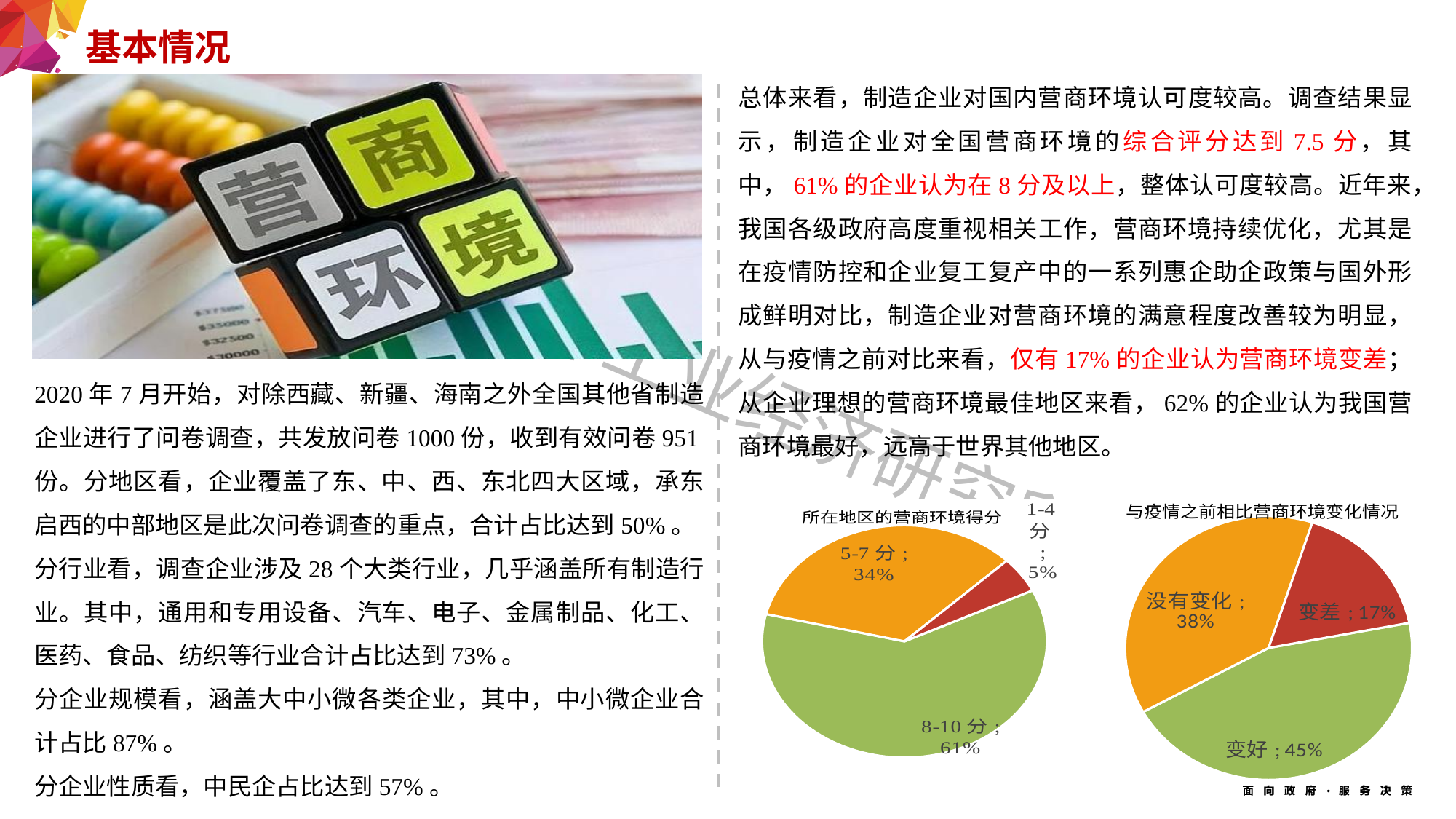
In the chart titled 与疫情之前相比营商环境变化情况, what share of enterprises answered 变差? 17% In the chart titled 所在地区的营商环境得分, what share of enterprises gave a score of 5-7 分? 34% In the chart titled 所在地区的营商环境得分, which score range has the smallest share? 1-4 分 In the chart titled 与疫情之前相比营商环境变化情况, what share of enterprises answered 变好? 45% What type of chart is the one titled 所在地区的营商环境得分? Pie chart In the chart titled 与疫情之前相比营商环境变化情况, which response has the largest share? 变好 In the chart titled 所在地区的营商环境得分, which score range has the largest share? 8-10 分 In the chart titled 与疫情之前相比营商环境变化情况, what share of enterprises answered 没有变化? 38% In the chart titled 与疫情之前相比营商环境变化情况, how many slices does the pie have? 3 In the chart titled 所在地区的营商环境得分, what is the difference in percentage points between the 8-10 分 slice and the 5-7 分 slice? 27 In the chart titled 所在地区的营商环境得分, what share of enterprises gave a score of 8-10 分? 61% In the chart titled 所在地区的营商环境得分, what share of enterprises gave a score of 1-4 分? 5%